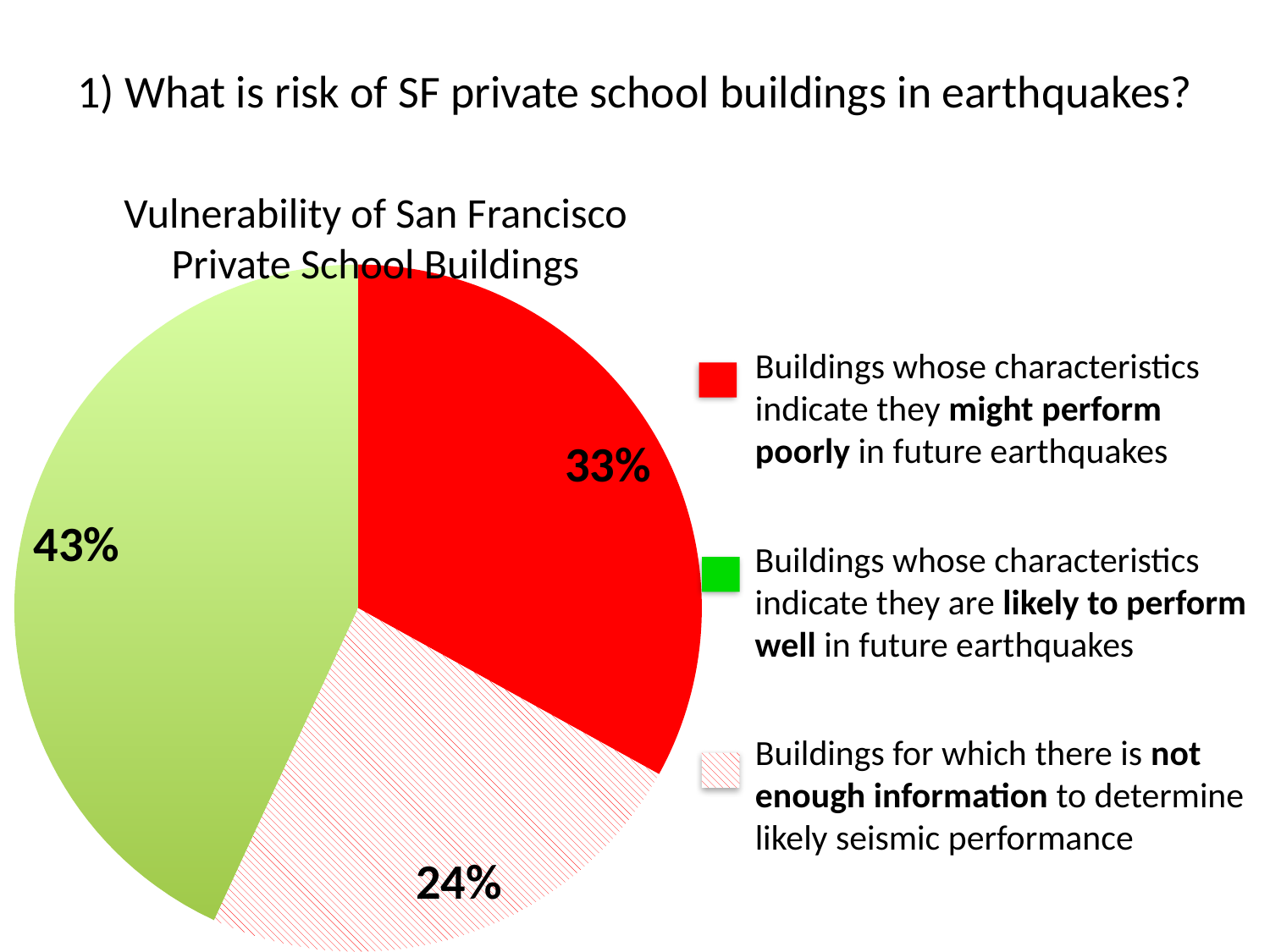
Which category has the smallest slice of the pie? Buildings for which there is not enough information to determine likely seismic performance What is the difference between the share of buildings that might perform poorly and the share with not enough information? 9% Which category has the largest slice of the pie? Buildings whose characteristics indicate they are likely to perform well in future earthquakes What share of the pie is for buildings for which there is not enough information to determine likely seismic performance? 24% What kind of chart is shown on the slide? pie chart What is the difference between the share of buildings likely to perform well and the share that might perform poorly? 10% What colour is the slice for buildings whose characteristics indicate they might perform poorly in future earthquakes? red What is the title of the chart? Vulnerability of San Francisco Private School Buildings What share of the pie is for buildings whose characteristics indicate they are likely to perform well in future earthquakes? 43% What share of the pie is for buildings whose characteristics indicate they might perform poorly in future earthquakes? 33% How many slices does the pie chart have? 3 Which is larger: the share of buildings that might perform poorly or the share with not enough information? Buildings that might perform poorly